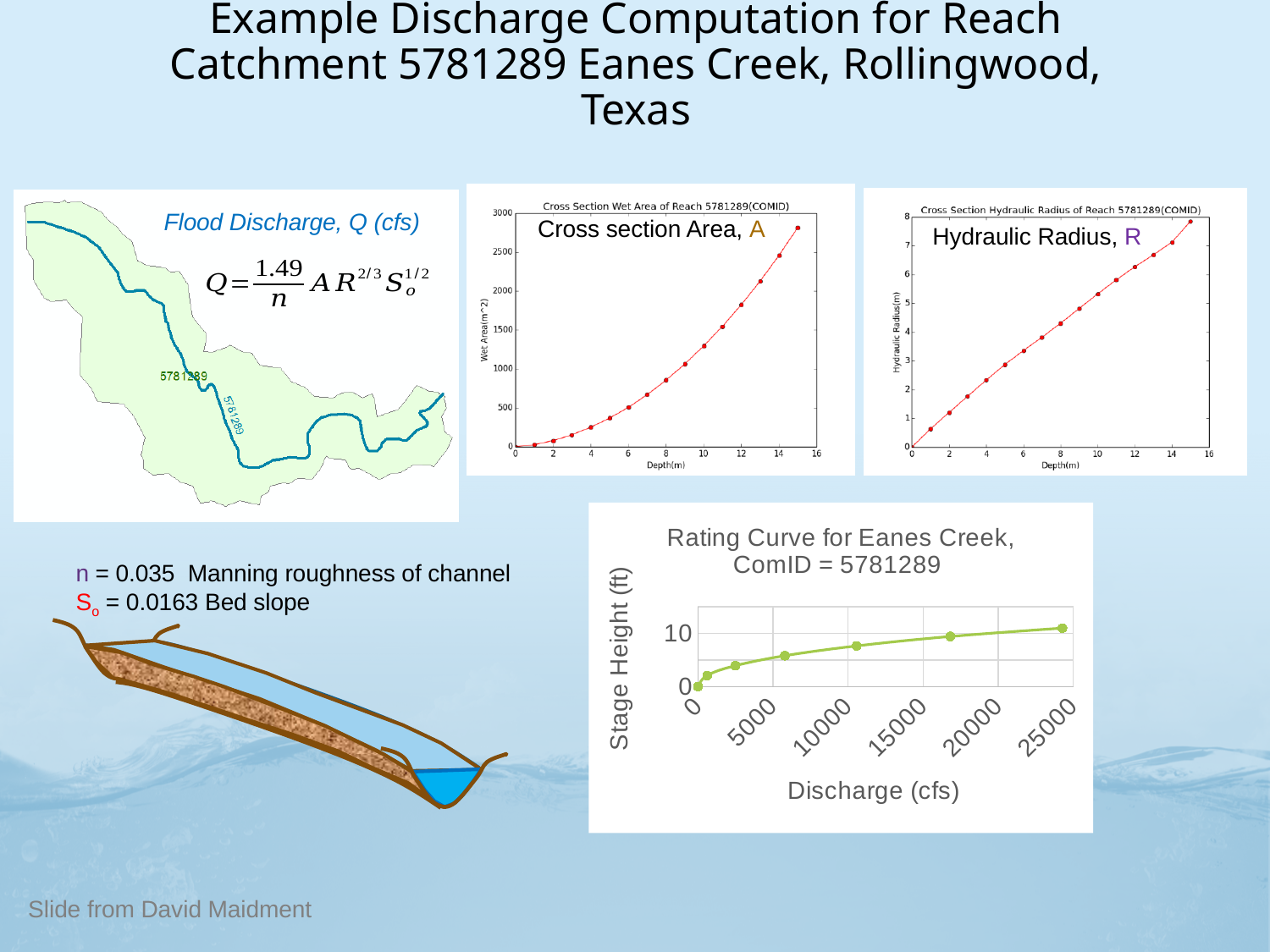
In the Rating Curve for Eanes Creek chart, does stage height rise or fall as discharge increases? rise In the Cross Section Hydraulic Radius chart, does the hydraulic radius rise or fall as depth increases? rise What is the x-axis label of the Rating Curve for Eanes Creek chart? Discharge (cfs) In the Cross Section Hydraulic Radius chart, is the hydraulic radius at a depth of 15 m greater or less than 7? greater What is the y-axis label of the Rating Curve for Eanes Creek chart? Stage Height (ft) What kind of chart is the Rating Curve for Eanes Creek chart? line chart In the Cross Section Wet Area chart, is the wet area at a depth of 15 m greater or less than 2500? greater In the Cross Section Wet Area chart, does the wet area rise or fall as depth increases? rise In the Rating Curve for Eanes Creek chart, is the stage height at a discharge of 25000 cfs greater or less than 10? greater